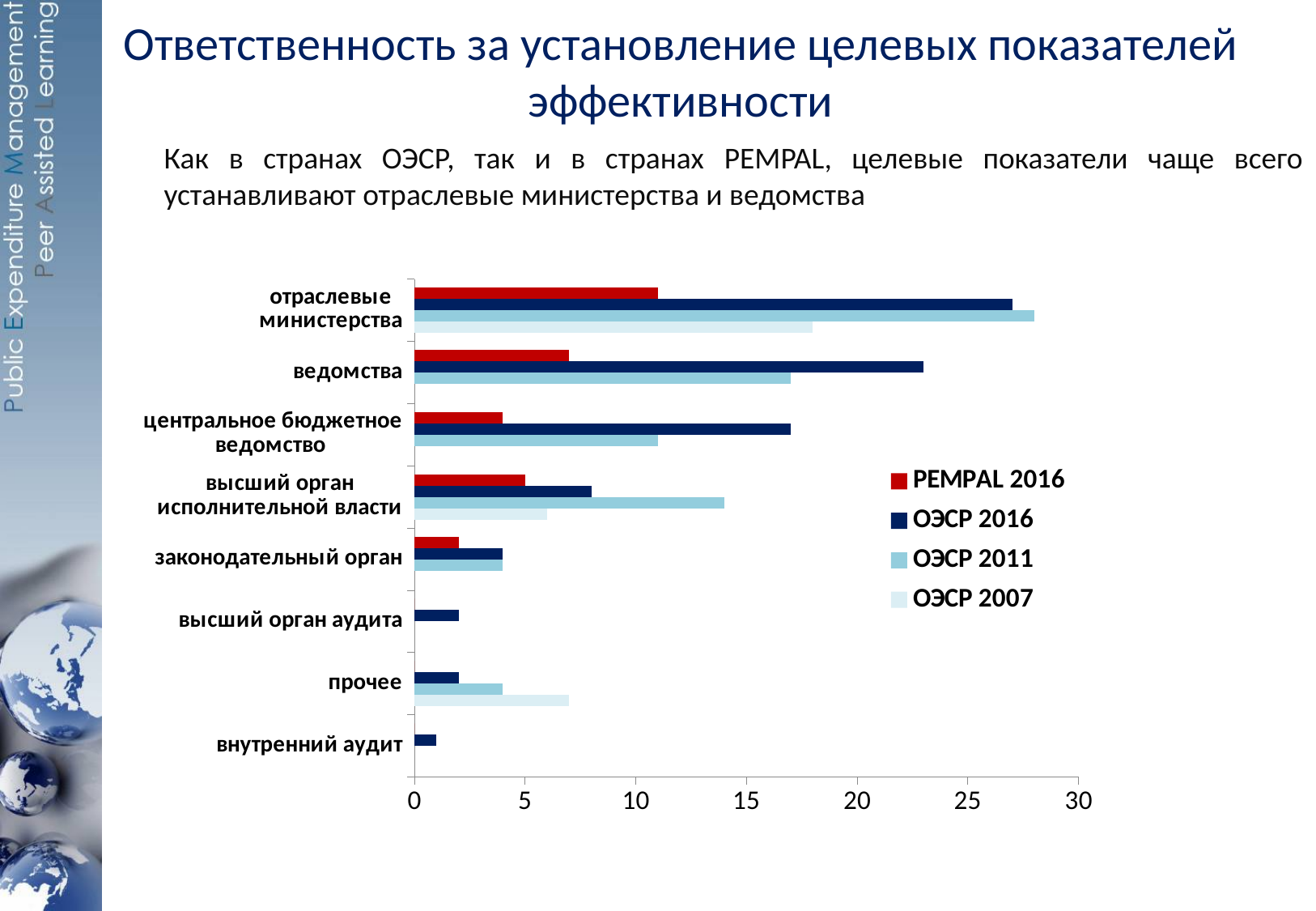
How many series does the legend list? 4 What colour represents the PEMPAL 2016 series in the legend? red Is the ОЭСР 2007 value for прочее greater or less than 5? greater Which category has the highest value for the ОЭСР 2016 series? отраслевые министерства Is the ОЭСР 2016 value for центральное бюджетное ведомство greater or less than 15? greater What kind of chart is shown on the slide? bar chart Which category has the highest value for the PEMPAL 2016 series? отраслевые министерства How many categories are shown on the vertical axis of the chart? 8 For высший орган исполнительной власти, which is larger: the ОЭСР 2011 value or the ОЭСР 2016 value? ОЭСР 2011 Is the ОЭСР 2016 value for ведомства greater or less than 20? greater For ведомства, which is larger: the ОЭСР 2016 value or the ОЭСР 2011 value? ОЭСР 2016